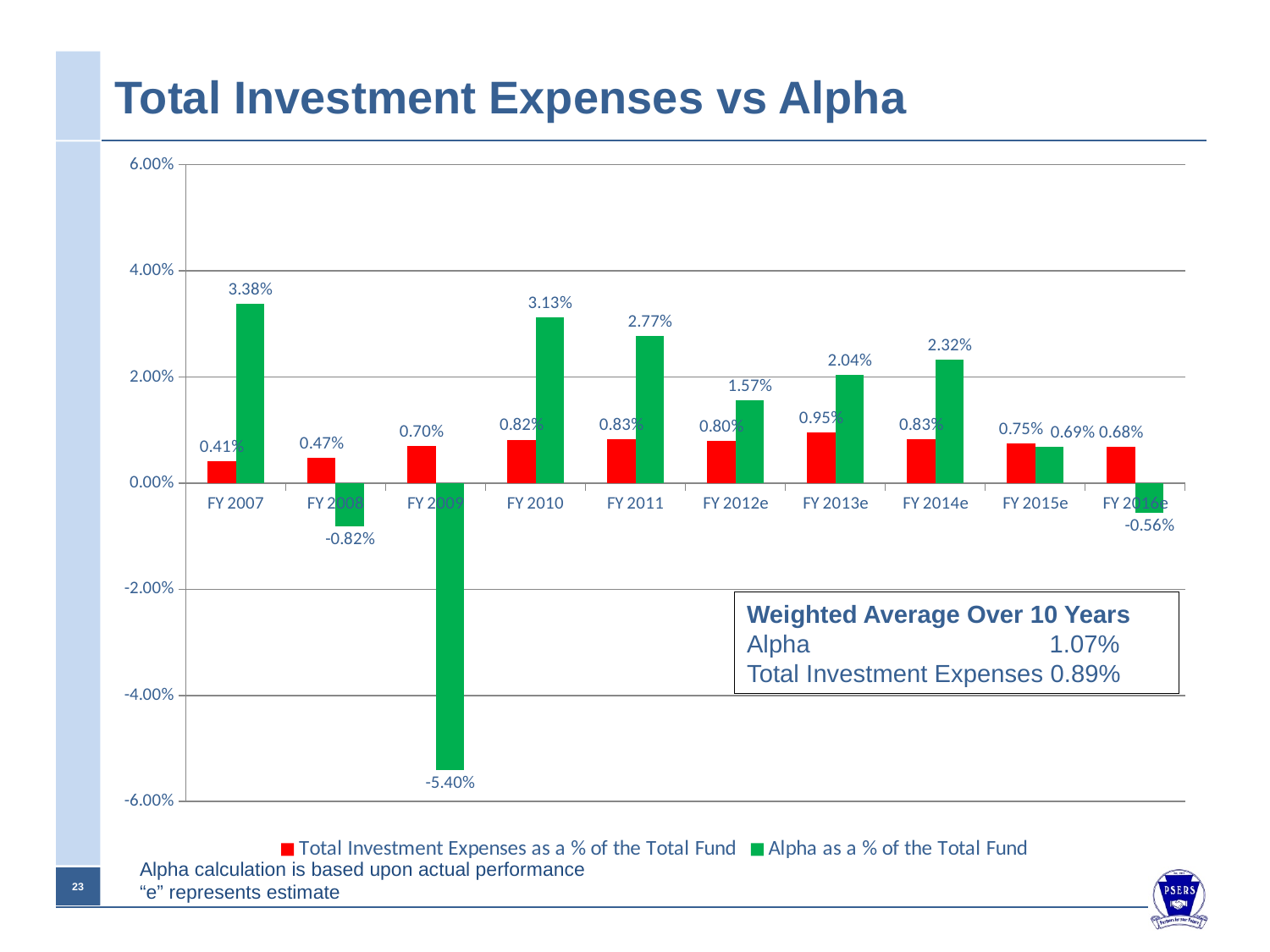
What is the Alpha as a % of the Total Fund for FY 2009? -5.40% Which fiscal year has the highest Alpha as a % of the Total Fund? FY 2007 How many series does the legend list? 2 What is the Total Investment Expenses as a % of the Total Fund for FY 2013e? 0.95% What is the difference between the Alpha for FY 2010 and the Alpha for FY 2011? 0.36% Which fiscal year has the lowest Alpha as a % of the Total Fund? FY 2009 How many fiscal years are shown on the x axis? 10 What is the Alpha as a % of the Total Fund for FY 2007? 3.38% Which fiscal year has the lowest Total Investment Expenses as a % of the Total Fund? FY 2007 Is the Alpha as a % of the Total Fund larger for FY 2011 or FY 2014e? FY 2011 What kind of chart is shown on the slide? Bar chart What is the weighted average Alpha over 10 years shown in the box on the chart? 1.07%